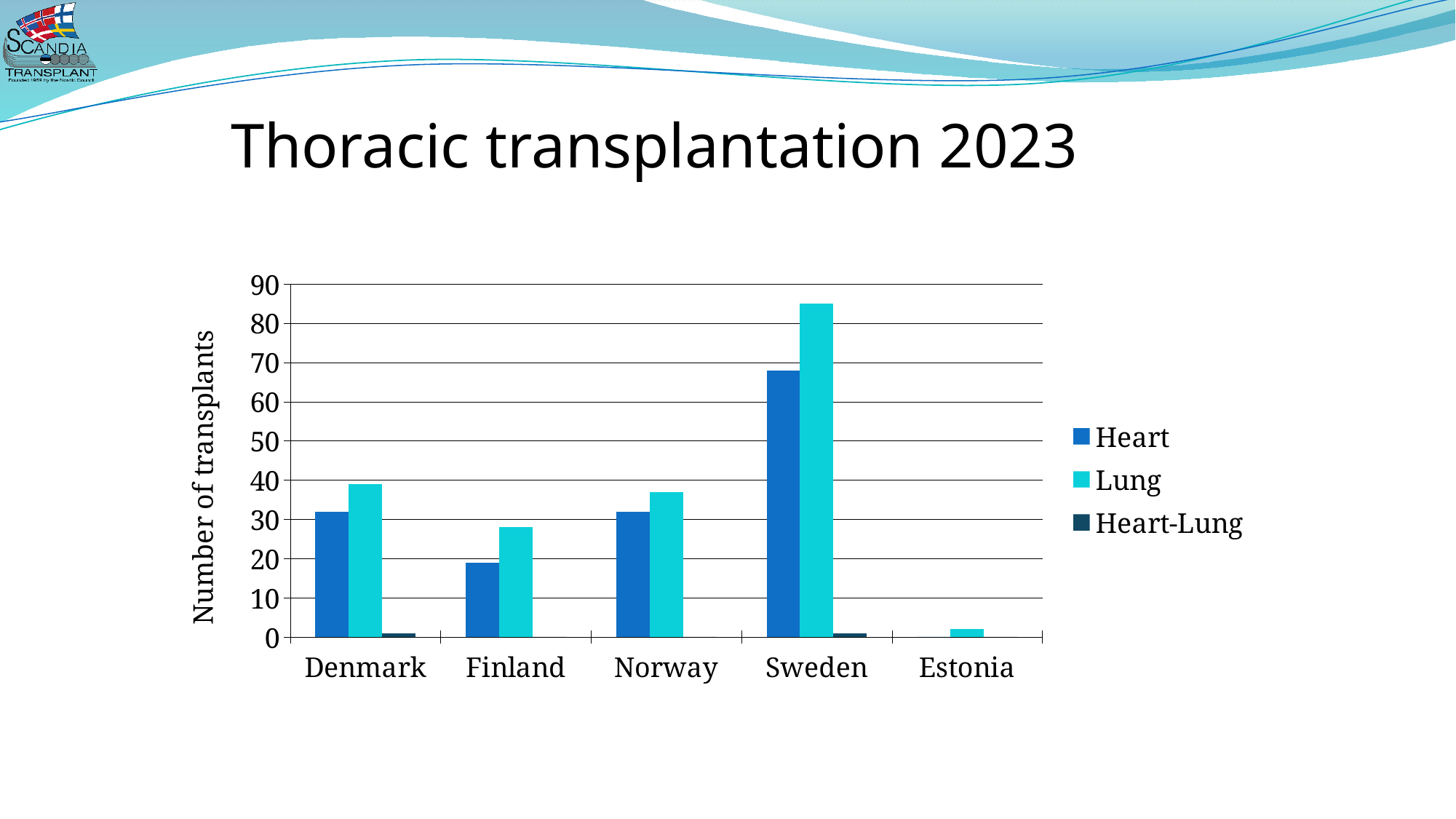
Which country has the highest Heart value? Sweden What kind of chart is shown on the slide? bar chart Is the Heart value for Sweden greater or less than 60? greater Is the Lung value for Sweden greater or less than 80? greater What is the label on the vertical axis? Number of transplants Which country has the lowest Lung value? Estonia How many series does the legend list? 3 Which country has the highest Lung value? Sweden For Sweden, which is larger: the Heart value or the Lung value? Lung Is the Lung value for Norway greater or less than 30? greater How many countries are shown on the x axis? 5